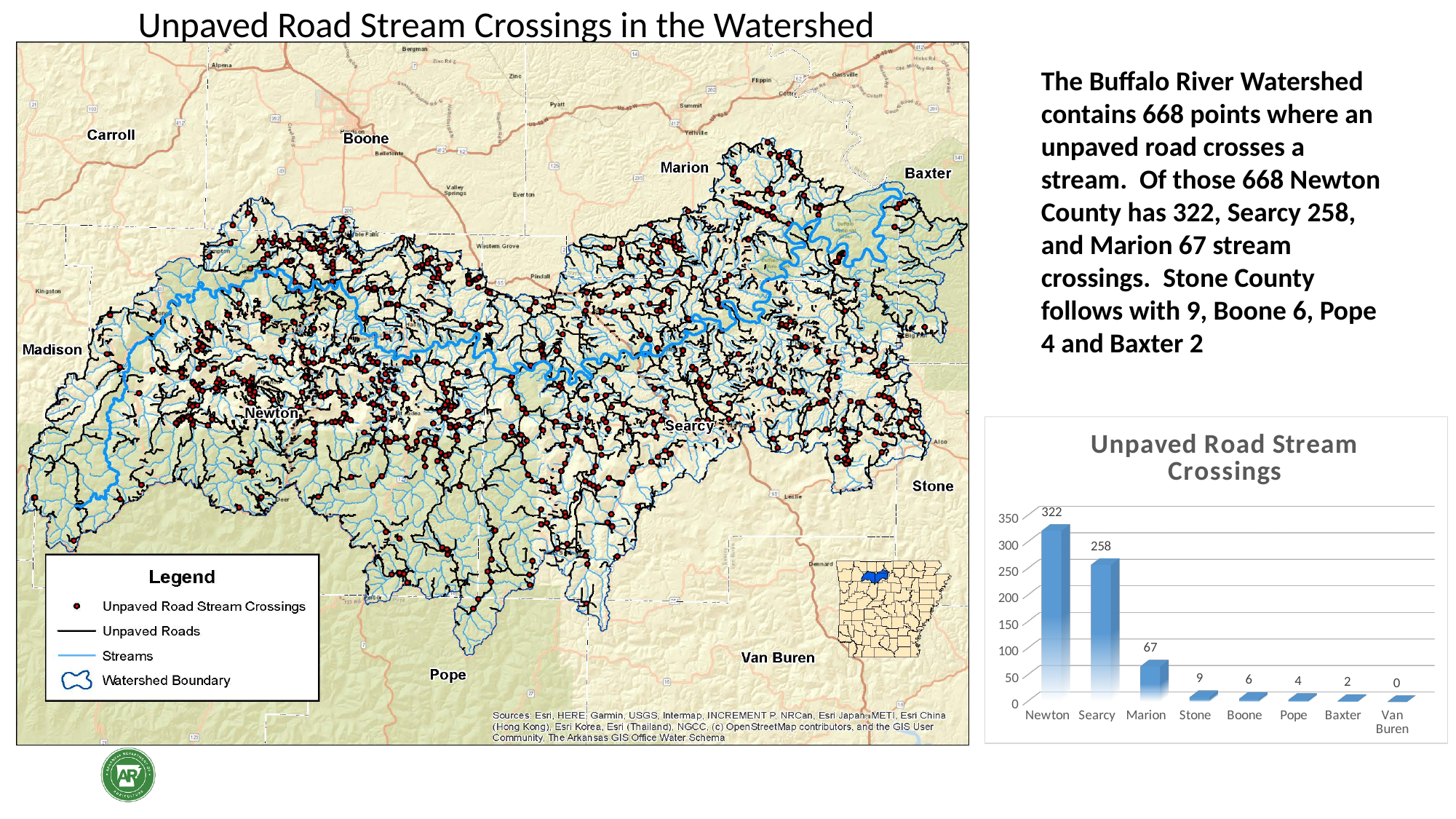
In the 'Unpaved Road Stream Crossings' chart, which county has the lowest number of crossings? Van Buren In the 'Unpaved Road Stream Crossings' chart, what is the difference between the values for Newton and Searcy? 64 In the 'Unpaved Road Stream Crossings' chart, what is the value for Marion? 67 What kind of chart is the 'Unpaved Road Stream Crossings' chart? bar chart In the 'Unpaved Road Stream Crossings' chart, how many crossings are shown for Newton? 322 In the 'Unpaved Road Stream Crossings' chart, which county has the highest number of crossings? Newton In the 'Unpaved Road Stream Crossings' chart, what is the value for Van Buren? 0 In the 'Unpaved Road Stream Crossings' chart, is the value for Marion greater or less than 100? less In the 'Unpaved Road Stream Crossings' chart, do the values rise or fall from left to right along the x axis? fall In the 'Unpaved Road Stream Crossings' chart, which has more crossings, Stone or Boone? Stone In the 'Unpaved Road Stream Crossings' chart, what is the value for Searcy? 258 How many counties are shown on the x axis of the 'Unpaved Road Stream Crossings' chart? 8